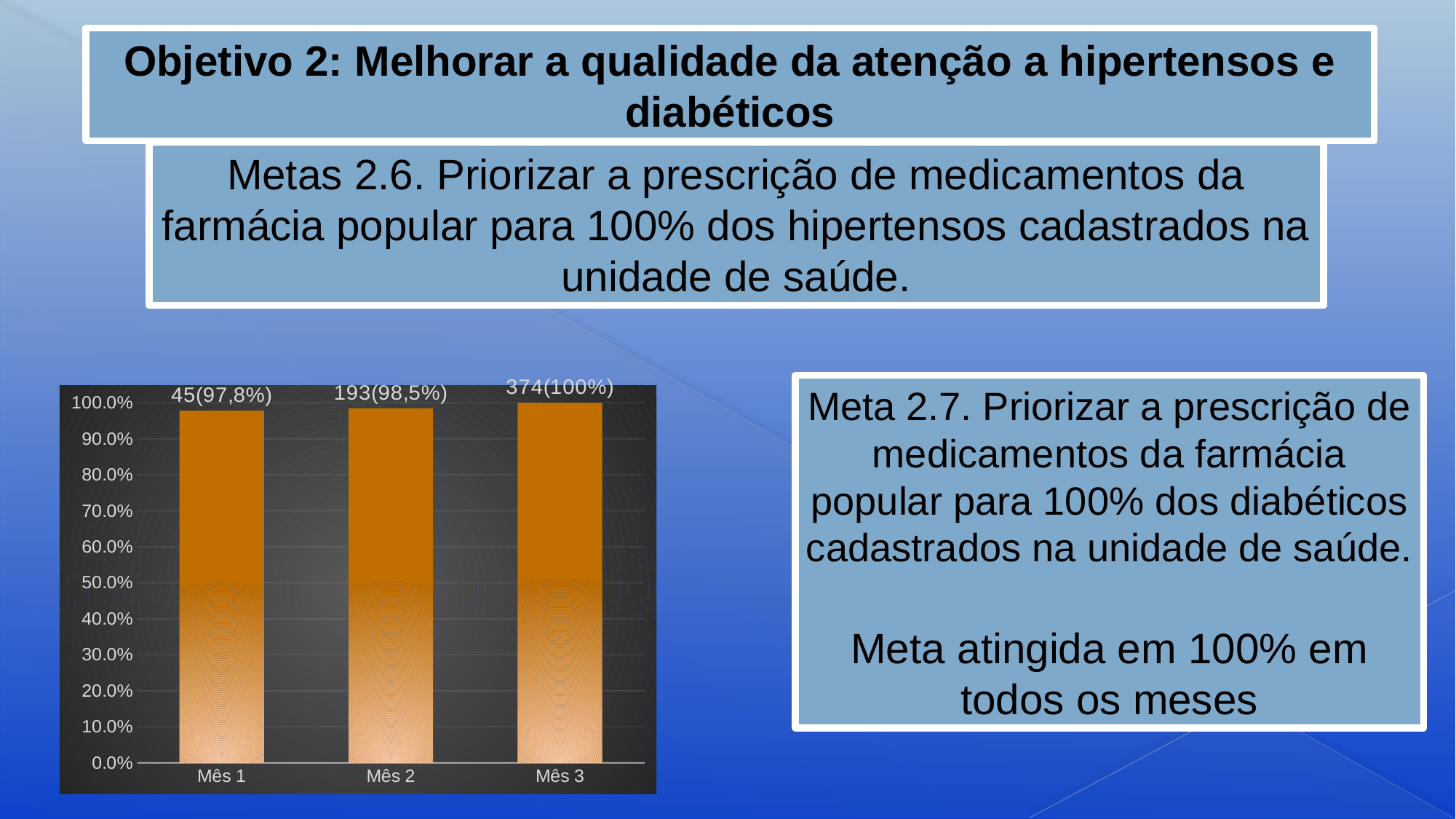
Which month has the lowest percentage in the chart? Mês 1 Is the percentage for Mês 1 greater or less than 90.0%? greater What percentage is shown in the data label for Mês 3? 100% How many categories are plotted on the x axis of the chart? 3 What is the highest tick value shown on the y axis of the chart? 100.0% What is the label of the first category on the x axis? Mês 1 What is the data label shown above the bar for Mês 1? 45(97,8%) Which month has the highest percentage in the chart? Mês 3 Do the percentages rise or fall from Mês 1 to Mês 3? rise What kind of chart is shown on the slide? bar chart What is the data label shown above the bar for Mês 3? 374(100%) What is the data label shown above the bar for Mês 2? 193(98,5%)